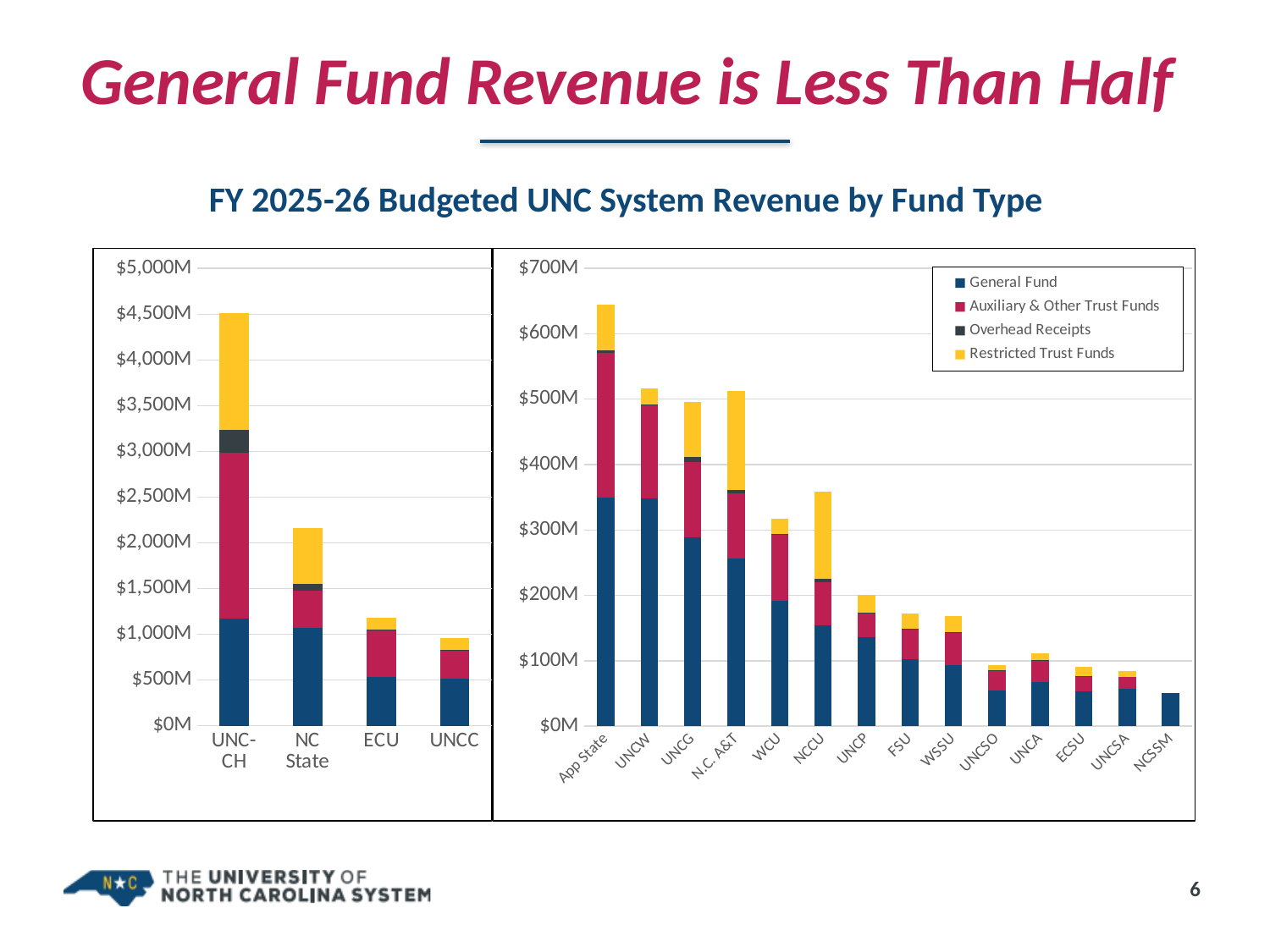
How many institutions are shown on the left chart? 4 What kind of chart is the left chart on the slide? Stacked bar chart On the right chart, do the total revenue values generally rise or fall moving from left to right along the x axis? fall On the left chart, which institution has the highest total revenue? UNC-CH How many series does the legend on the right chart list? 4 On the right chart, which institution has the highest total revenue? App State How many institutions are shown on the right chart? 14 Which colour represents Restricted Trust Funds in the legend? Yellow On the right chart, which institution has the lowest total revenue? NCSSM On the right chart, is the total revenue for App State greater or less than $600M? greater On the left chart, which institution has the lowest total revenue? UNCC On the left chart, is the total revenue for UNC-CH greater or less than $4,000M? greater